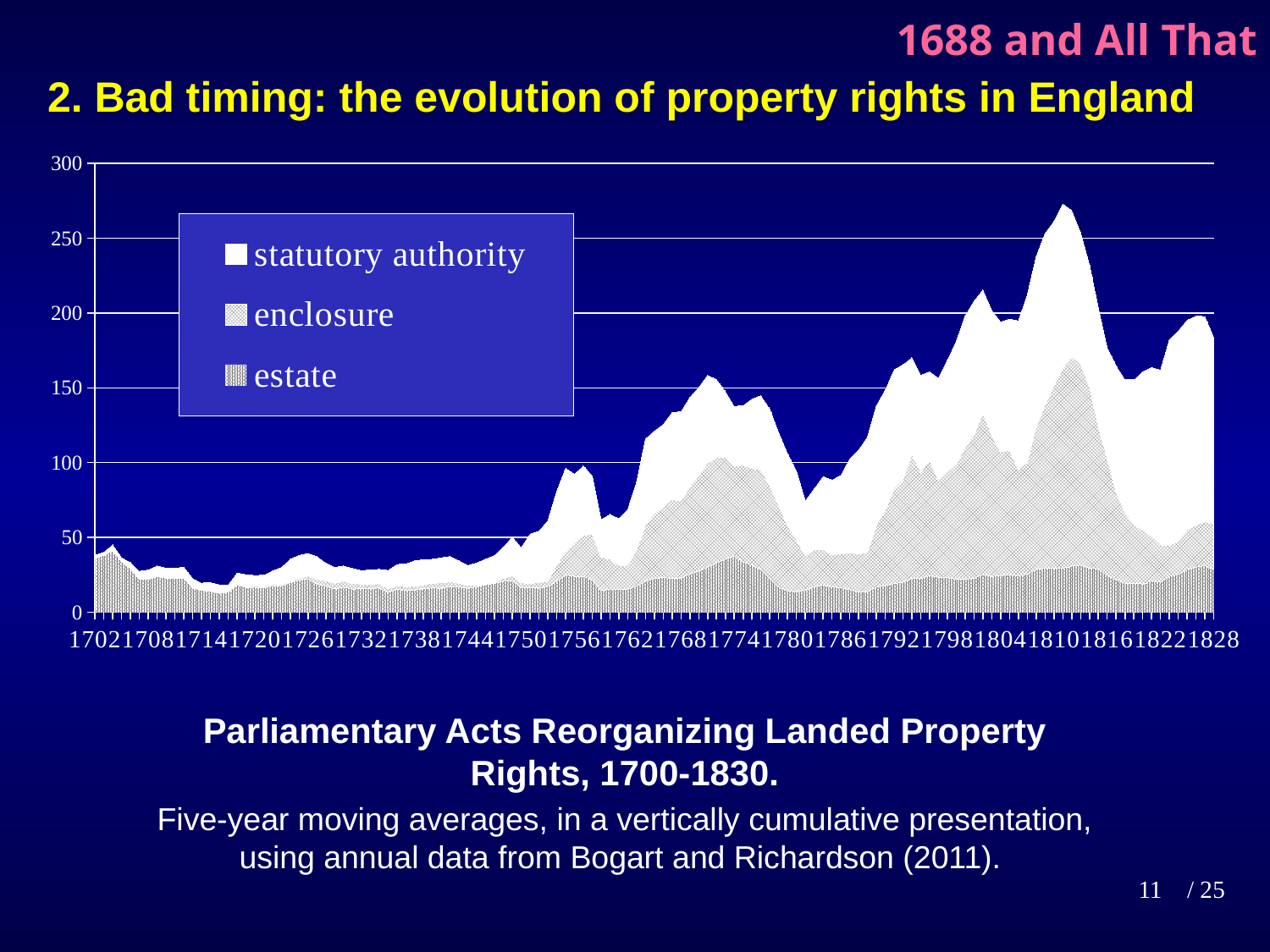
What kind of chart is shown on the slide? stacked area chart How many series does the legend list? 3 What is the highest value shown on the vertical axis? 300 What are the three series named in the legend? statutory authority, enclosure, estate Around which labelled year does the cumulative total reach its highest point? 1810 How many year labels are shown along the x axis? 22 Is the cumulative total at 1702 greater or less than 50? less What is the title of the chart? Parliamentary Acts Reorganizing Landed Property Rights, 1700-1830. Is the cumulative total at its peak around 1810 greater or less than 250? greater Is the cumulative total at 1828 greater or less than 200? less Does the cumulative total rise or fall between 1810 and 1816? fall